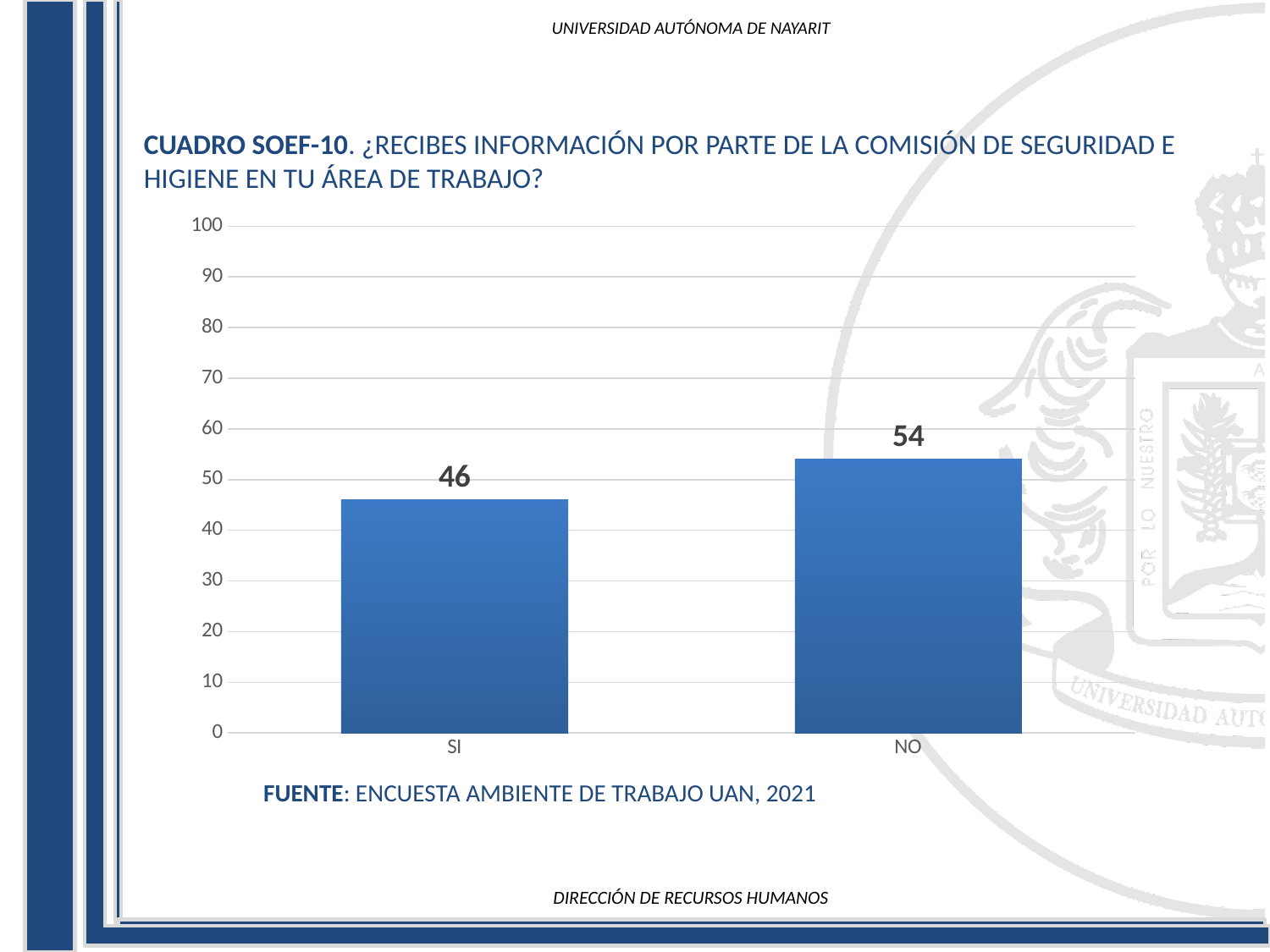
Which is larger, the value for SI or the value for NO? NO What is the difference between the values for NO and SI? 8 What kind of chart is shown on the slide? bar chart Is the value for NO greater or less than 50? greater What source is cited below the chart? ENCUESTA AMBIENTE DE TRABAJO UAN, 2021 What is the value for SI? 46 Which category has the highest value? NO What is the total of the values for SI and NO? 100 How many categories are shown on the x axis? 2 Is the value for SI greater or less than 50? less Which category has the lowest value? SI What is the value for NO? 54